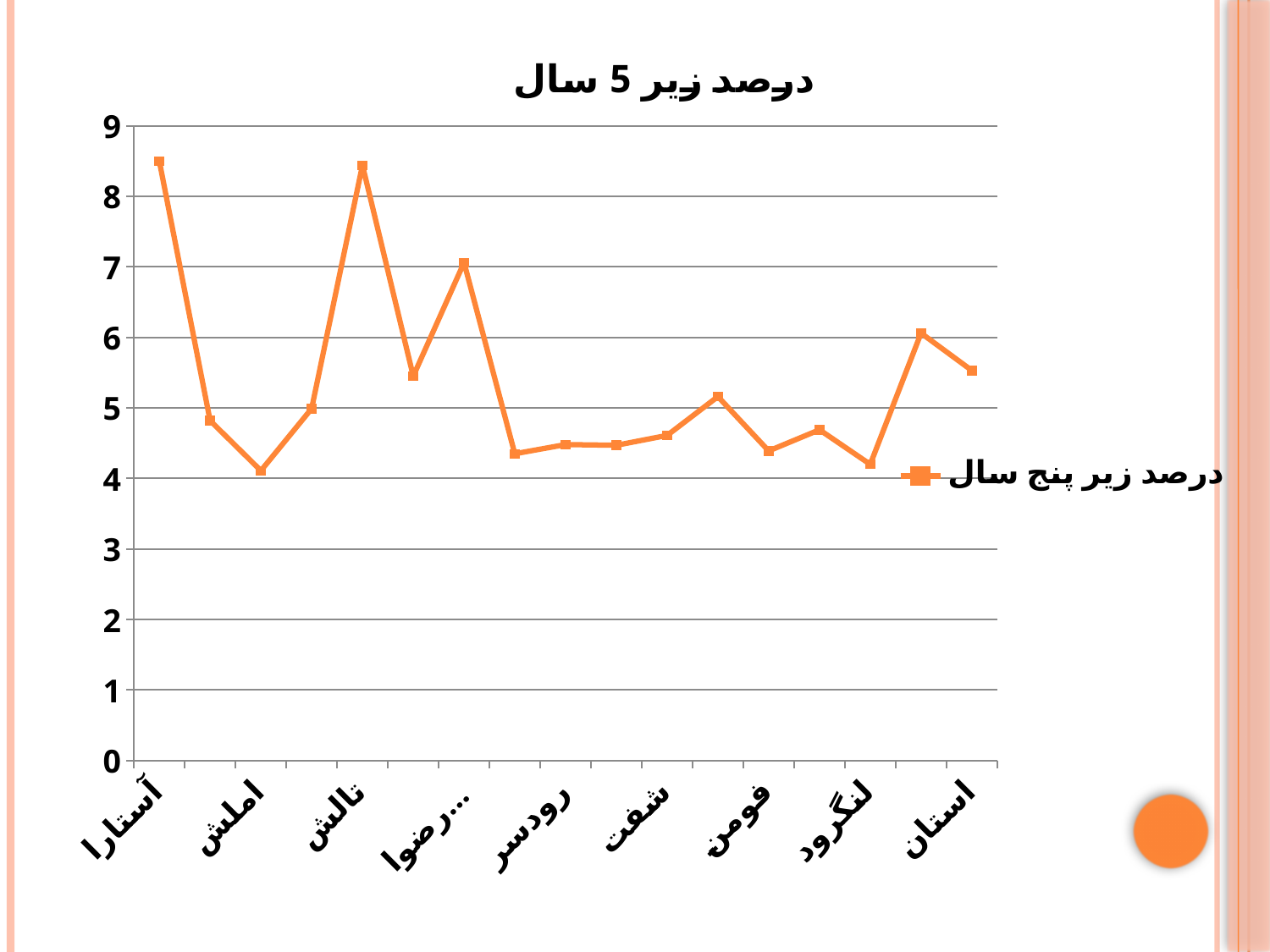
Is the value for املش greater or less than 5? less What is the title of the chart? درصد زیر 5 سال What kind of chart is shown on the slide? line chart Is the value for رودسر greater or less than 5? less Which has the larger value, استان or لنگرود? استان How many series does the legend list? 1 Which has the larger value, تالش or رودسر? تالش Is the value for تالش greater or less than 8? greater Which has the larger value, آستارا or املش? آستارا